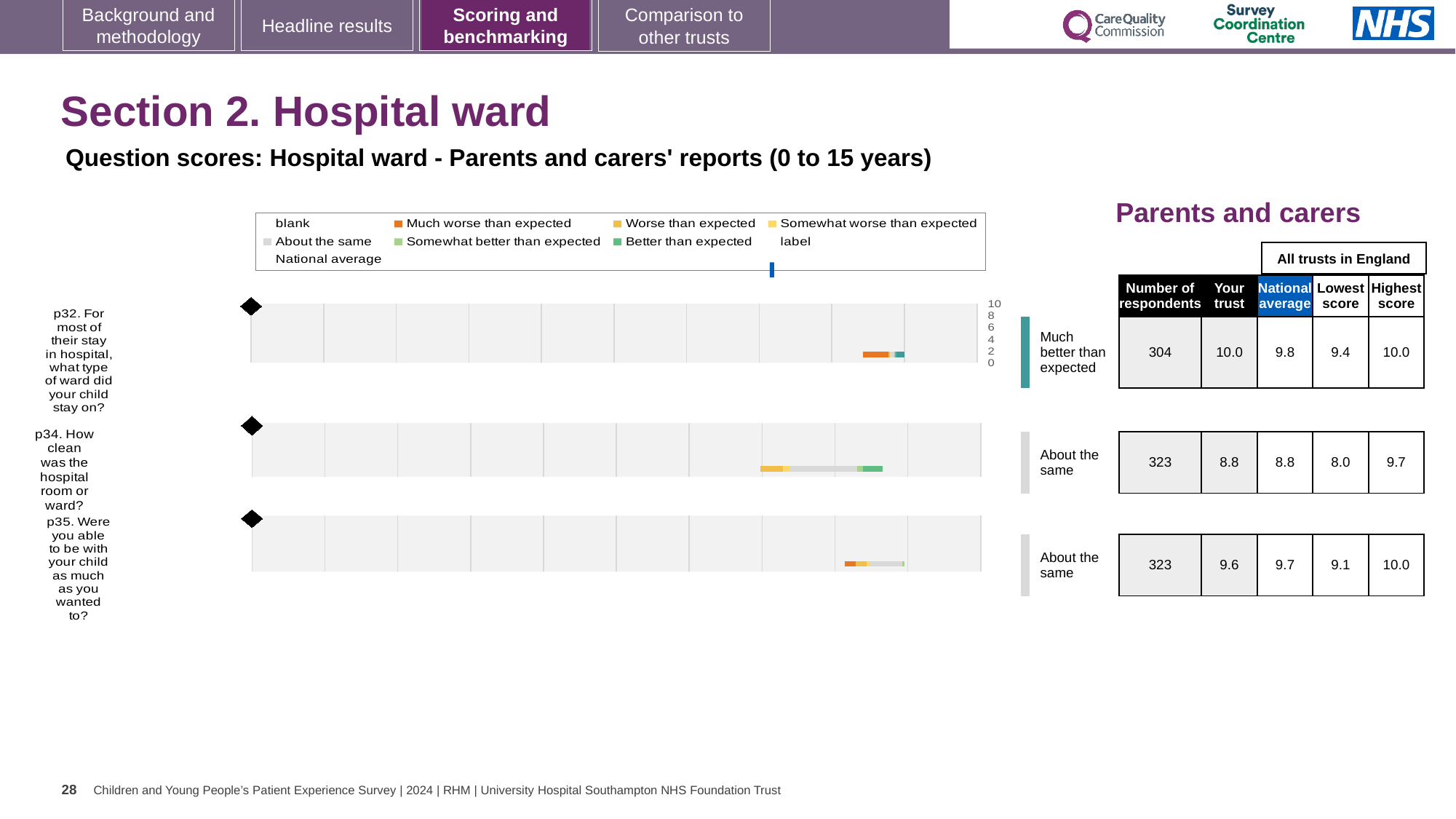
How many respondents answered p32? 304 What benchmark category is shown for p32? Much better than expected Which question has the lowest 'Your trust' score? p34 What is the lowest score among all trusts in England for p34? 8.0 What is the 'Your trust' score for p32 (what type of ward did your child stay on)? 10.0 What kind of chart is used to show the question scores on this slide? bar chart What is the difference between the highest score and the lowest score for p34? 1.7 Which question has the highest 'Your trust' score? p32 What is the national average score for p35 (were you able to be with your child as much as you wanted to)? 9.7 What is the 'Your trust' score for p34 (how clean was the hospital room or ward)? 8.8 For p32, which is larger: the 'Your trust' score or the national average? Your trust How many questions (bars) are shown in the chart? 3